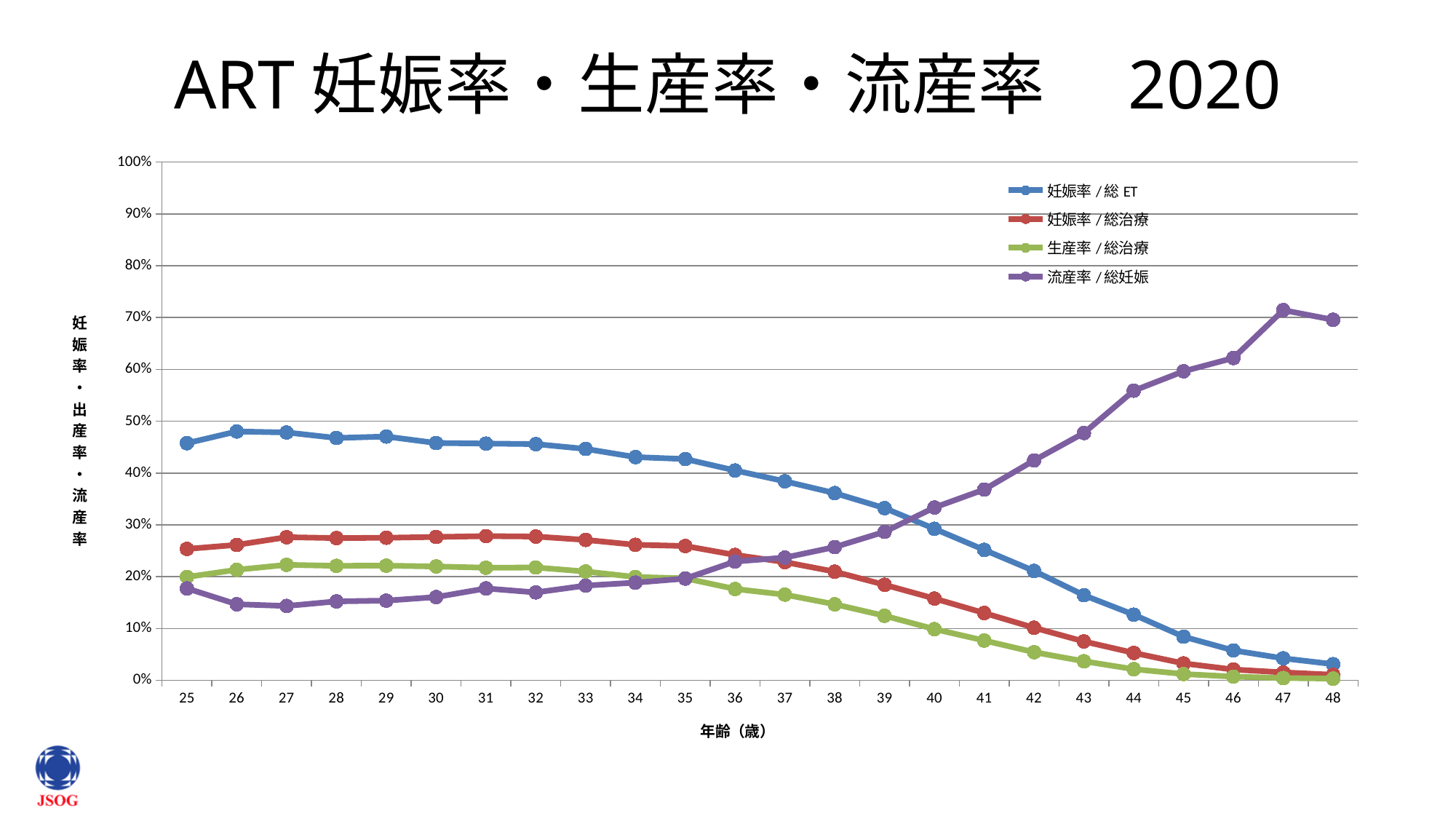
At which age is the 流産率 / 総妊娠 series highest? 47 Is the value of 生産率 / 総治療 at age 40 greater or less than 20%? less How many series does the legend list? 4 At age 45, which is larger: 流産率 / 総妊娠 or 妊娠率 / 総治療? 流産率 / 総妊娠 Does the 流産率 / 総妊娠 series rise or fall overall as age increases along the x axis? rise Is the value of 妊娠率 / 総 ET at age 25 greater or less than 40%? greater How many age categories are plotted along the x axis? 24 Is the value of 流産率 / 総妊娠 at age 48 greater or less than 60%? greater What kind of chart is shown on the slide? line chart Does the 妊娠率 / 総 ET series rise or fall overall as age increases along the x axis? fall What is the title of the x axis? 年齢（歳） At which age is the 妊娠率 / 総 ET series lowest? 48